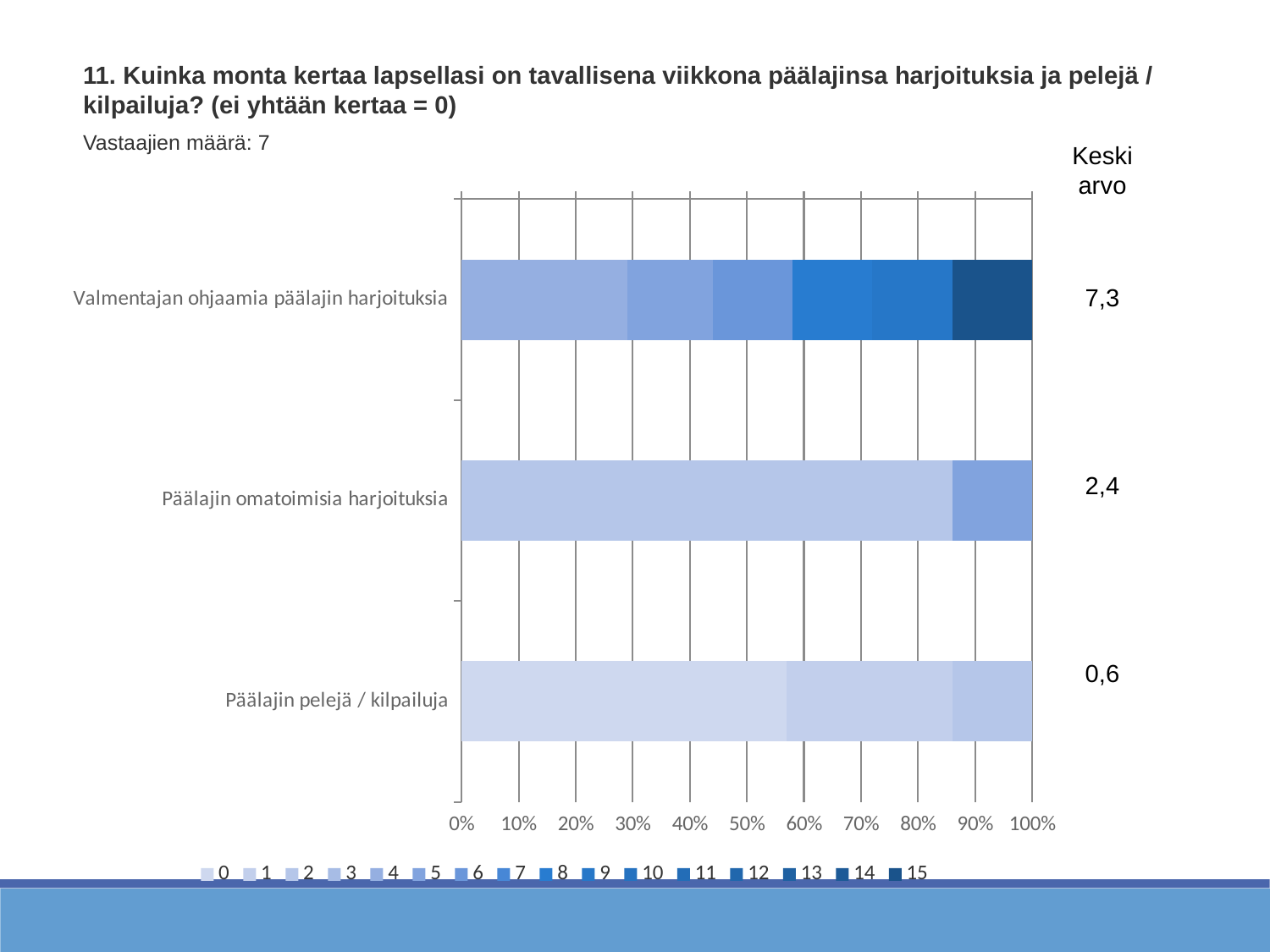
What is the Keskiarvo (mean) shown for Valmentajan ohjaamia päälajin harjoituksia? 7,3 What is the Keskiarvo (mean) shown for Päälajin omatoimisia harjoituksia? 2,4 What kind of chart is shown on the slide? bar chart How many respondents (Vastaajien määrä) are reported on the slide? 7 How many categories are plotted on the chart? 3 What is the difference between the Keskiarvo of Valmentajan ohjaamia päälajin harjoituksia and Päälajin omatoimisia harjoituksia? 4,9 Which has the larger Keskiarvo: Päälajin omatoimisia harjoituksia or Päälajin pelejä / kilpailuja? Päälajin omatoimisia harjoituksia Which category has the highest Keskiarvo (mean)? Valmentajan ohjaamia päälajin harjoituksia How many series does the legend list? 16 Is the share of the first (lightest, '0') segment in the Päälajin pelejä / kilpailuja bar greater or less than 50%? greater What is the Keskiarvo (mean) shown for Päälajin pelejä / kilpailuja? 0,6 Which category has the lowest Keskiarvo (mean)? Päälajin pelejä / kilpailuja